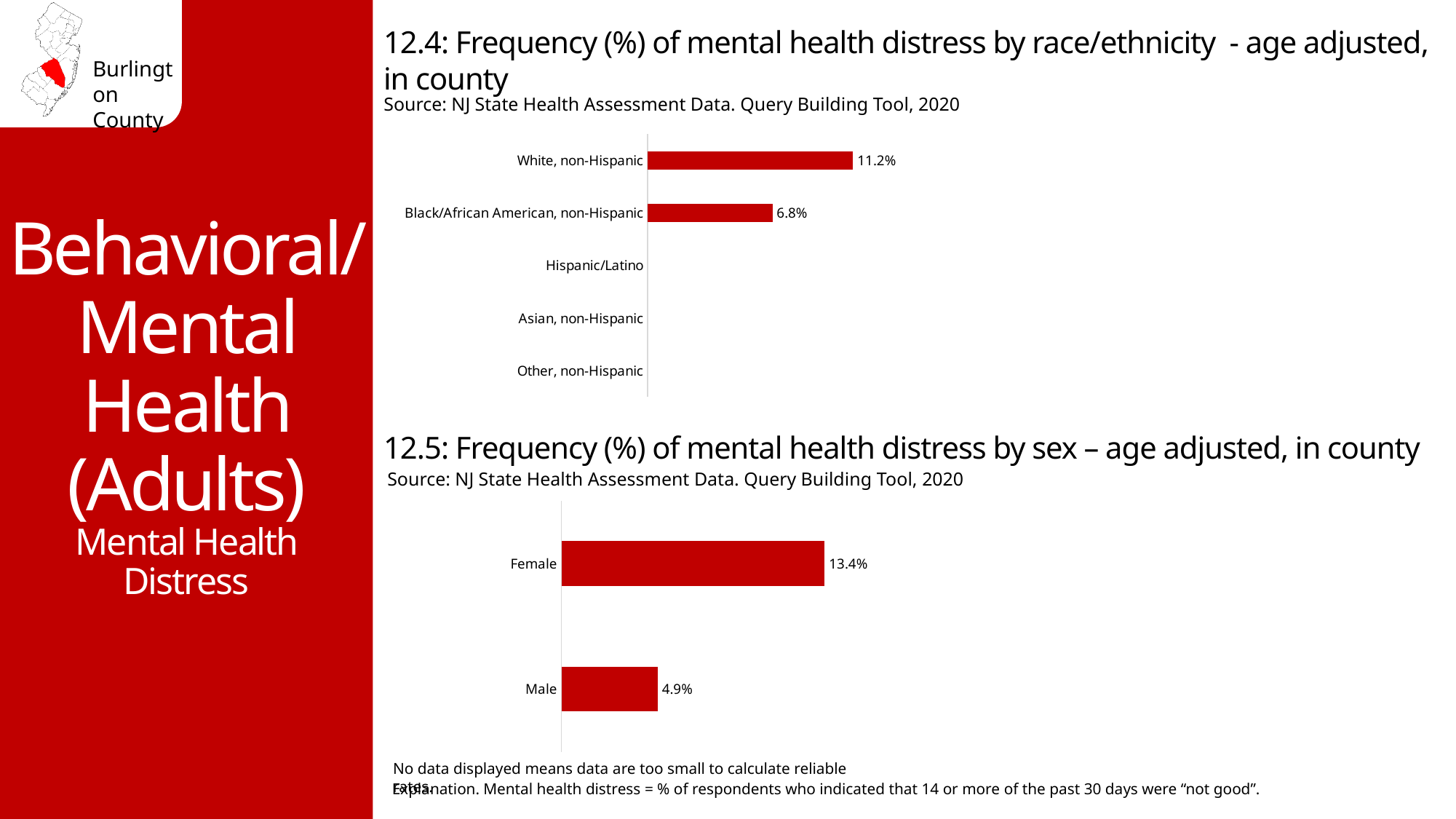
In the chart 12.5 (mental health distress by sex), what is the value for Female? 13.4% In the chart 12.4 (mental health distress by race/ethnicity), what is the difference between the White, non-Hispanic and Black/African American, non-Hispanic values? 4.4% In the chart 12.4 (mental health distress by race/ethnicity), what is the value for White, non-Hispanic? 11.2% In the chart 12.4 (mental health distress by race/ethnicity), what is the value for Black/African American, non-Hispanic? 6.8% In the chart 12.5 (mental health distress by sex), which category has the lowest value? Male In the chart 12.4 (mental health distress by race/ethnicity), how many categories are listed on the axis? 5 In the chart 12.5 (mental health distress by sex), which is larger, the value for Female or for Male? Female What is the source cited for the chart 12.5 (mental health distress by sex)? NJ State Health Assessment Data. Query Building Tool, 2020 In the chart 12.4 (mental health distress by race/ethnicity), what kind of chart is shown? Bar chart In the chart 12.5 (mental health distress by sex), what is the difference between the Female and Male values? 8.5% In the chart 12.4 (mental health distress by race/ethnicity), which category has the highest value? White, non-Hispanic In the chart 12.5 (mental health distress by sex), what is the value for Male? 4.9%